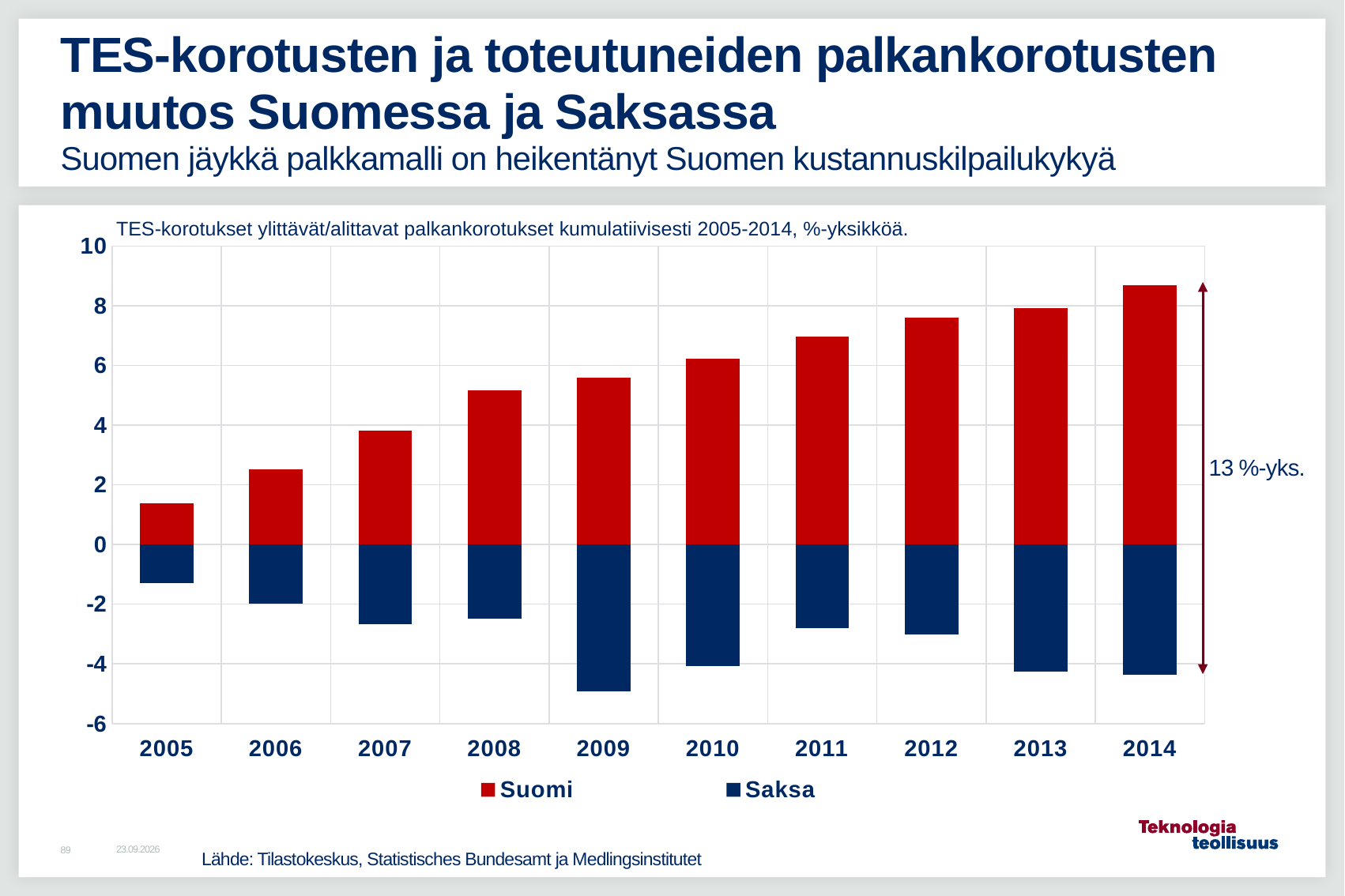
How many years are shown on the x axis of the chart? 10 What value does the arrow annotation on the right side of the chart show for 2014? 13 %-yks. Do the Suomi values rise or fall from 2005 to 2014? rise Is the Saksa value for 2009 greater or less than -4? less In which year is the Suomi bar the highest? 2014 In which year does the Saksa bar reach its lowest (most negative) value? 2009 What kind of chart is shown on the slide? Stacked bar chart Which is larger, the Suomi value for 2009 or the Suomi value for 2010? 2010 Which series is shown in red in the chart? Suomi Is the Suomi value for 2005 greater or less than 2? less Is the Suomi value for 2014 greater or less than 8? greater How many series does the chart legend list? 2